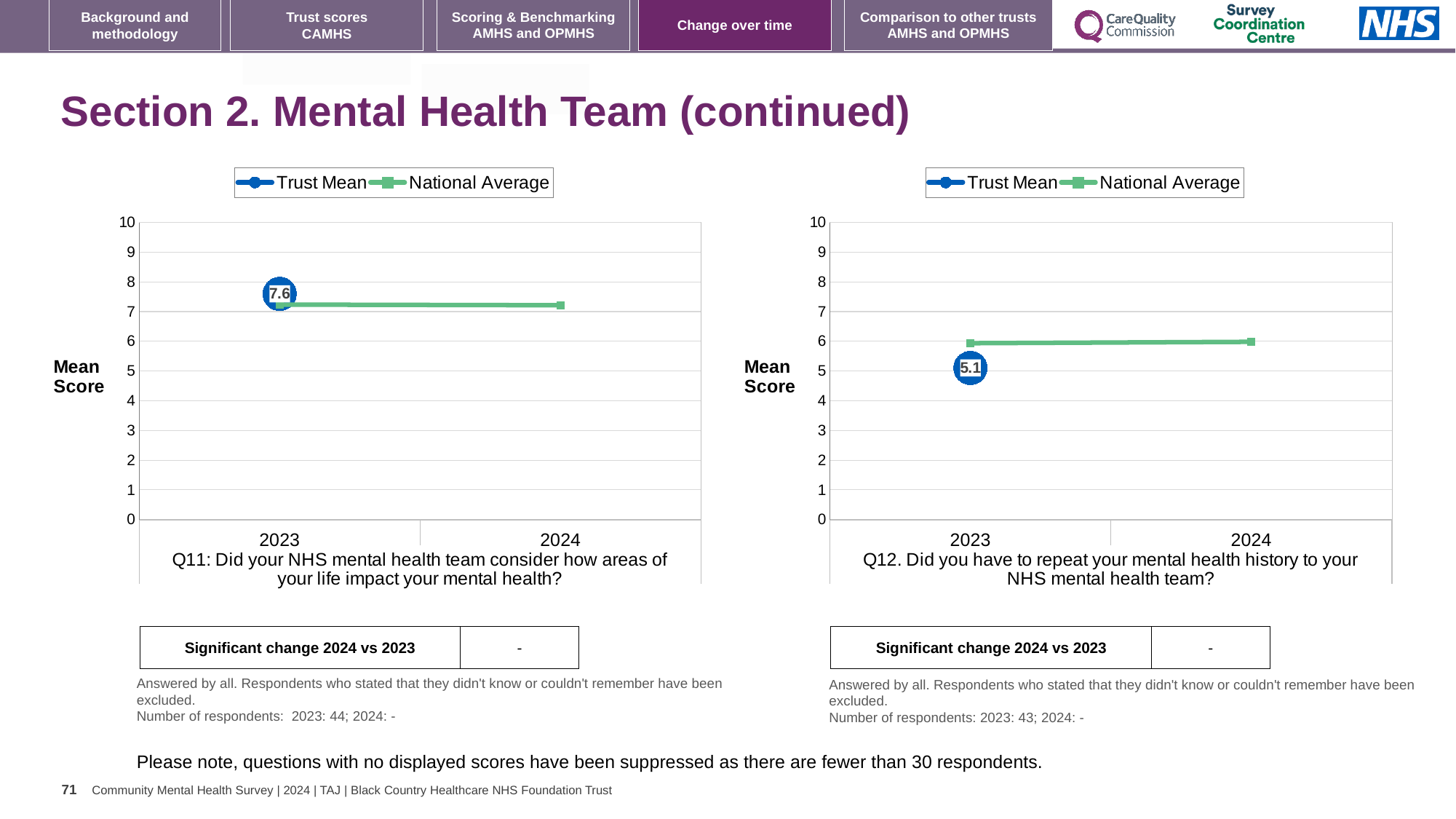
In the right chart (Q12), what is the Trust Mean score for 2023? 5.1 How many series does the legend of the left chart (Q11) list? 2 What kind of chart is the right chart (Q12)? Line chart In the right chart (Q12), is the National Average value for 2024 greater or less than 5? greater In the right chart (Q12), which is higher in 2023: the Trust Mean or the National Average? National Average In the left chart (Q11), which is higher in 2023: the Trust Mean or the National Average? Trust Mean What are the two legend entries shown above the right chart (Q12)? Trust Mean and National Average What is the y-axis label of the left chart (Q11)? Mean Score In the right chart (Q12), is the National Average value for 2023 greater or less than 7? less How many years are shown on the x axis of the left chart (Q11)? 2 In the left chart (Q11), what is the Trust Mean score for 2023? 7.6 In the left chart (Q11), is the National Average value for 2024 greater or less than 8? less